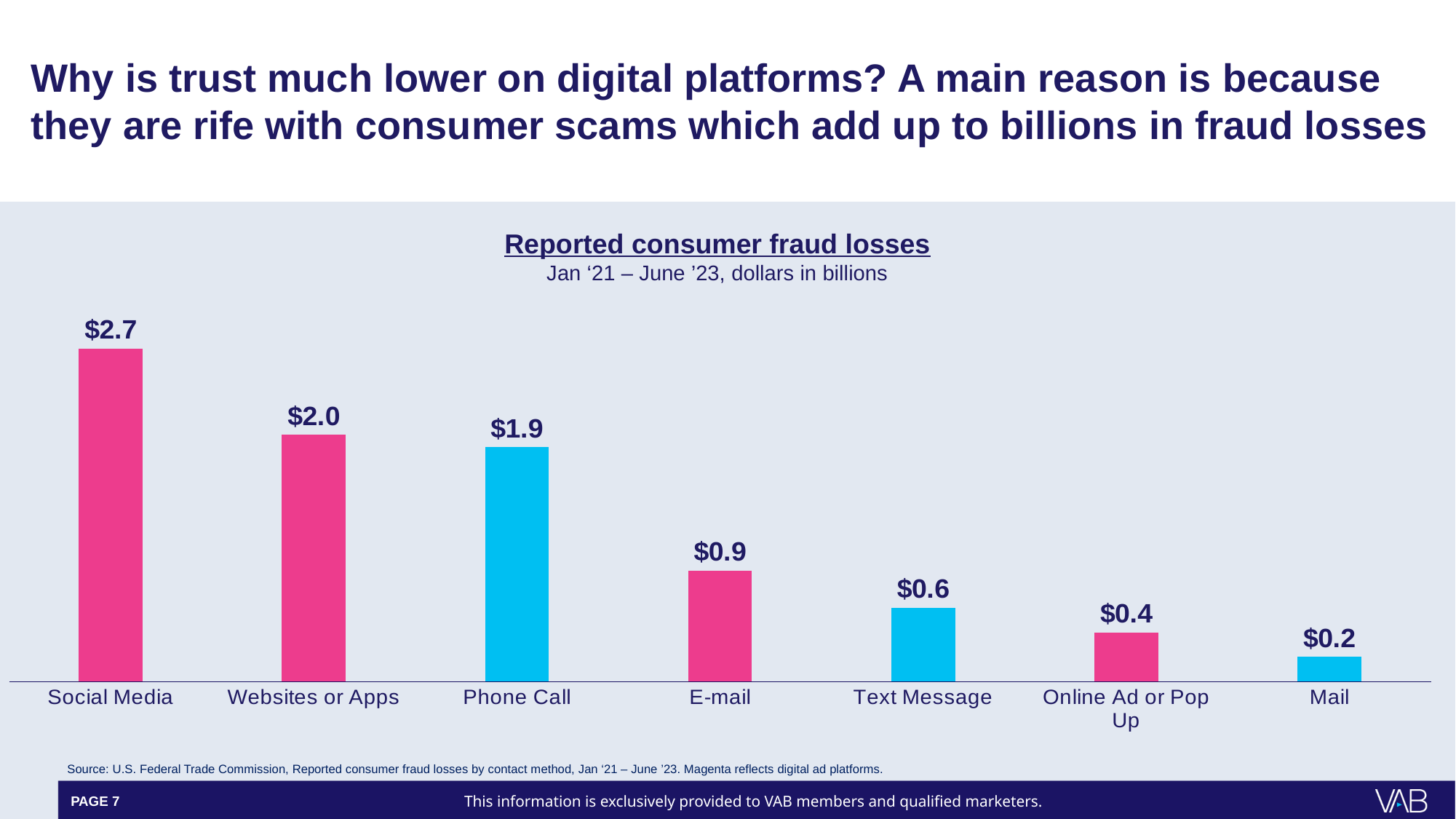
Which contact method has the highest reported consumer fraud losses? Social Media What kind of chart is shown on the slide? Bar chart What is the difference between the fraud losses for Social Media and Websites or Apps? $0.7 Which has higher reported fraud losses, Websites or Apps or Phone Call? Websites or Apps What is the reported consumer fraud loss for Phone Call? $1.9 Do the values rise or fall moving from left to right across the categories? Fall What is the reported consumer fraud loss for Text Message? $0.6 How many contact method categories are shown in the chart? 7 What is the title of the chart? Reported consumer fraud losses Which contact method has the lowest reported consumer fraud losses? Mail What is the reported consumer fraud loss for Social Media? $2.7 What is the difference between the fraud losses for E-mail and Online Ad or Pop Up? $0.5